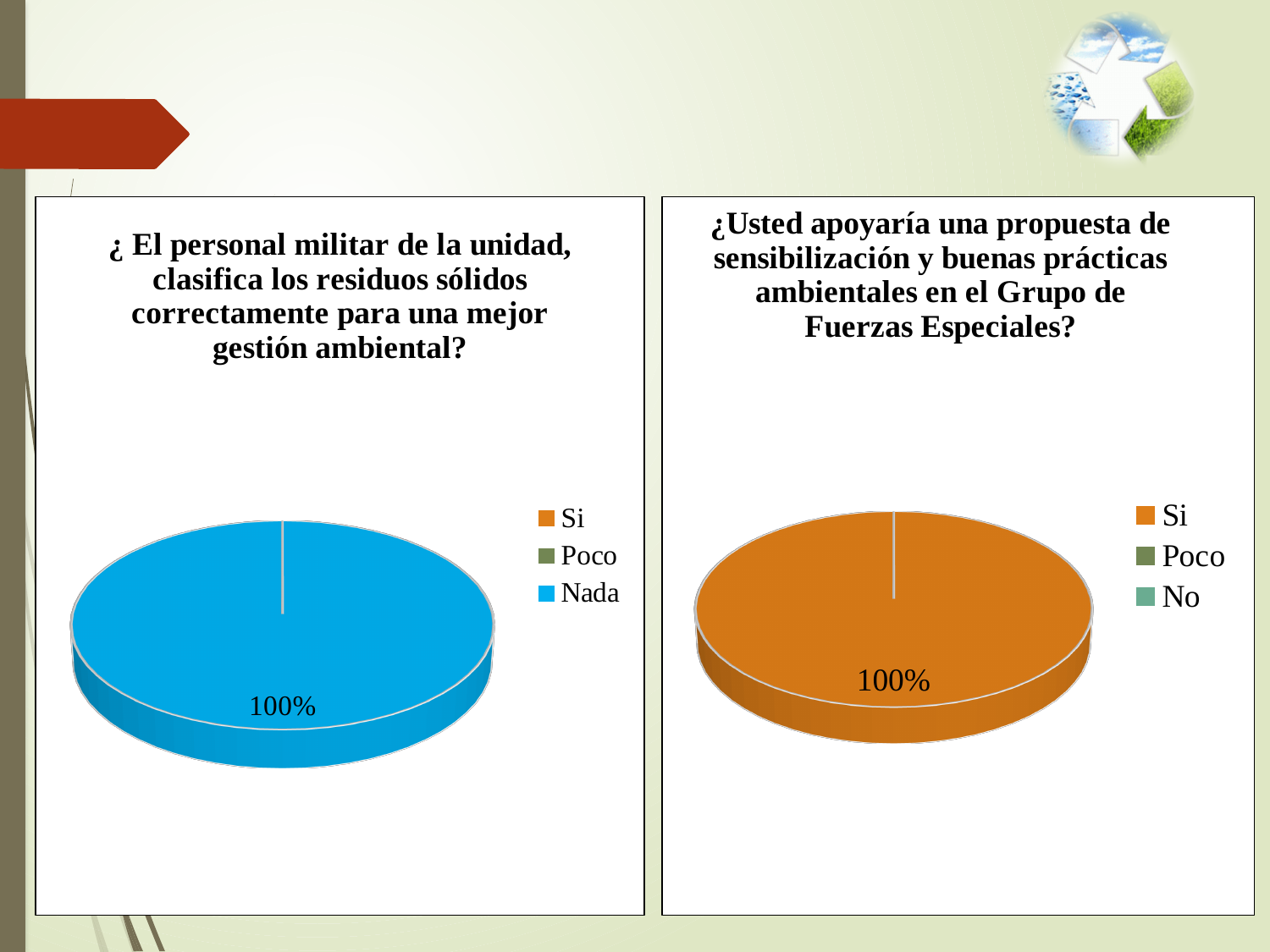
What are the legend entries of the right chart? Si, Poco, No How many entries does the legend of the left chart list? 3 How many entries does the legend of the right chart list? 3 In the right chart, which category makes up the whole pie? Si In the left chart, which category makes up the whole pie? Nada In the left chart, is the share for Nada greater or less than 50%? greater What kind of chart is the right chart on the slide? Pie chart What kind of chart is the left chart on the slide? Pie chart What are the legend entries of the left chart? Si, Poco, Nada In the right chart, is the share for Si greater or less than 50%? greater In the right chart (¿Usted apoyaría una propuesta de sensibilización...?), what share of the pie does Si have? 100% In the left chart (¿El personal militar de la unidad, clasifica los residuos sólidos correctamente...?), what share of the pie does Nada have? 100%